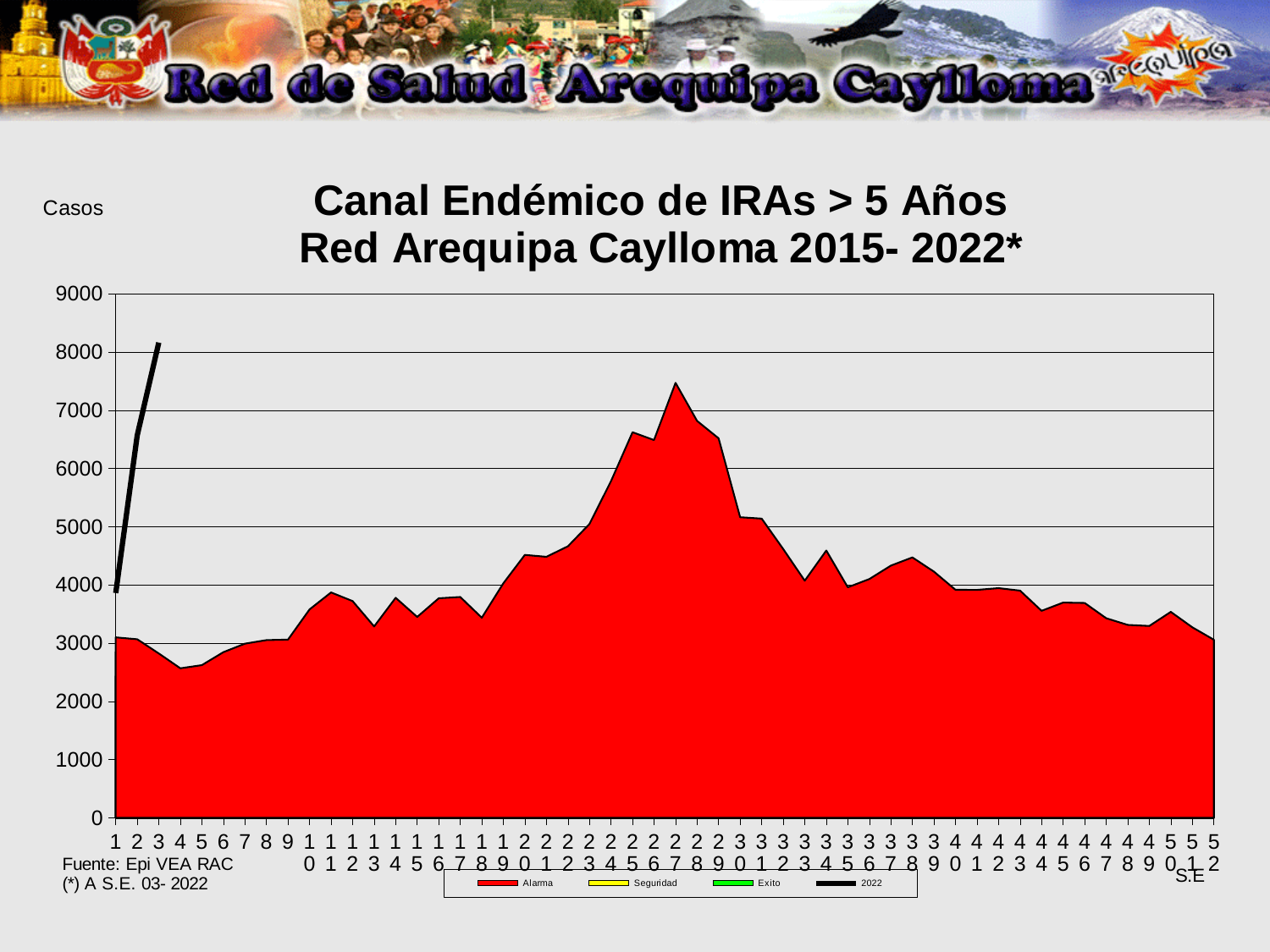
Is the 2022 line value at week 2 greater or less than 6000? greater At which week does the Alarma area reach its highest value? 27 Does the 2022 line rise or fall from week 1 to week 3? rise Which is larger, the Alarma value at week 10 or at week 4? week 10 What is the title of the chart? Canal Endémico de IRAs > 5 Años Red Arequipa Caylloma 2015- 2022* How many series does the chart legend list? 4 What kind of chart is shown on the slide? Area chart with a line series What colour represents the Alarma series? Red Which is larger, the Alarma value at week 27 or at week 1? week 27 How many epidemiological weeks (S.E.) are shown along the x axis? 52 Is the Alarma value at week 27 greater or less than 7000? greater Is the Alarma value at week 1 greater or less than 4000? less